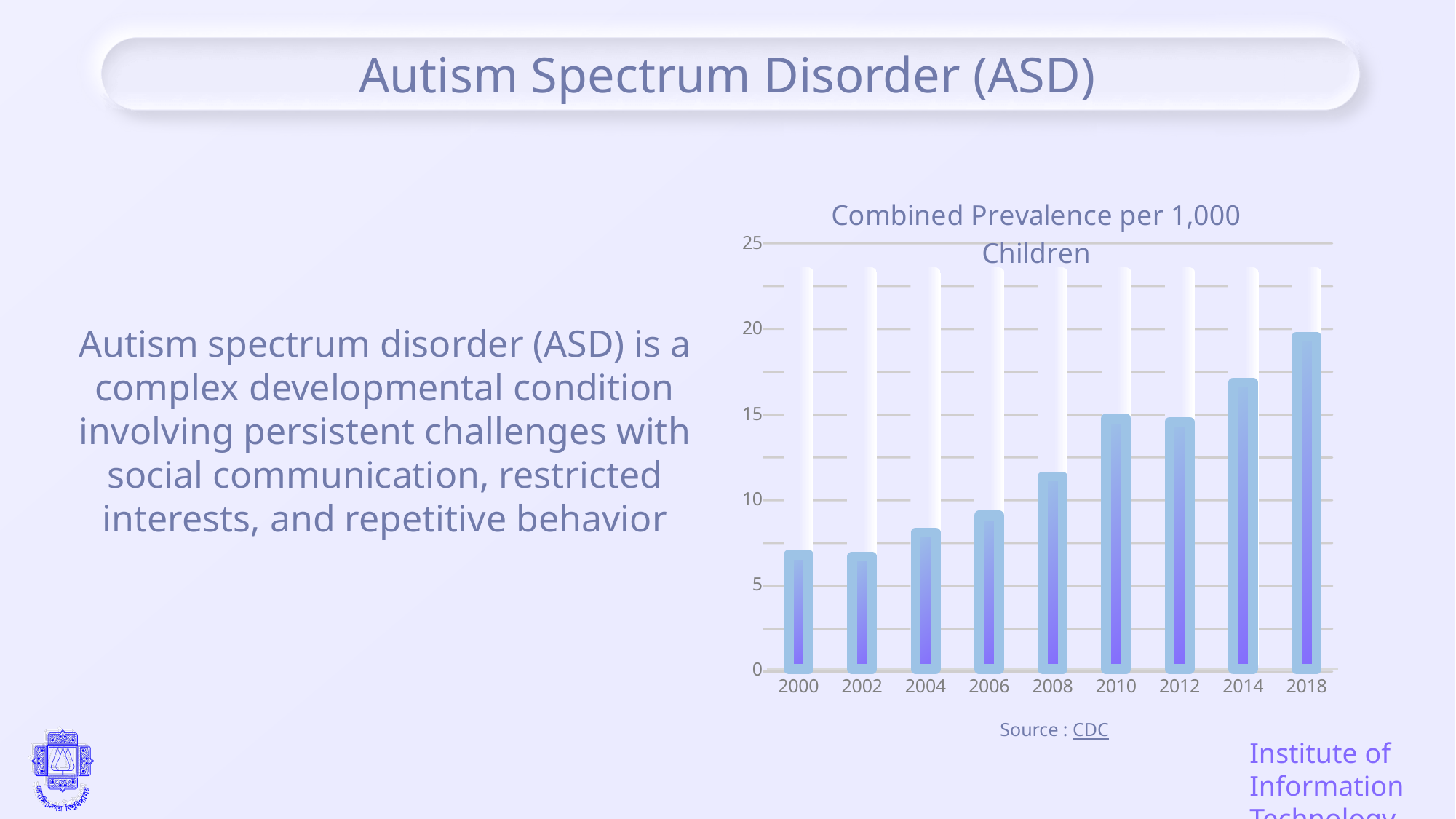
Is the value for 2004 greater or less than 10? less How many years are plotted on the x axis of the chart? 9 Is the value for 2014 greater or less than 20? less Is the value for 2000 greater or less than 5? greater What is the title of the chart? Combined Prevalence per 1,000 Children What kind of chart is shown on the slide? bar chart What source is cited below the chart? CDC Which year has the larger value, 2008 or 2014? 2014 Do the values generally rise or fall from 2000 to 2018? rise Which year has the highest combined prevalence per 1,000 children? 2018